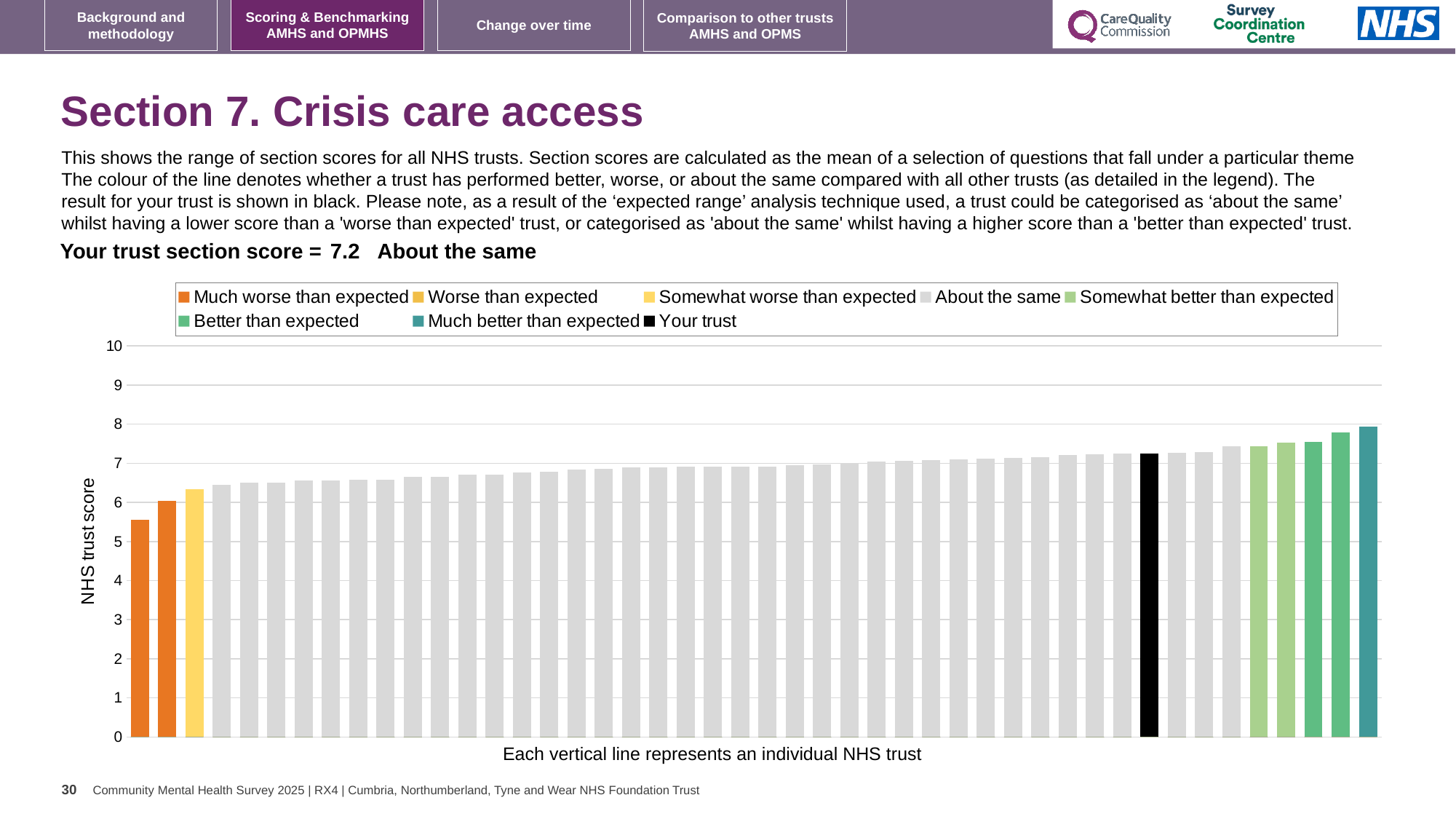
Is the value for your trust (black bar) greater or less than 7? greater Which legend category does the lowest bar on the chart belong to? Much worse than expected Is the value of the lowest bar on the chart greater or less than 6? less Which category is your trust placed in for this section? About the same Which legend category does the highest bar on the chart belong to? Much better than expected What kind of chart is shown on the slide? Bar chart What is the label on the vertical axis of the chart? NHS trust score What is your trust's section score for Crisis care access? 7.2 How many entries does the chart legend list? 8 How many bars are coloured as 'Much worse than expected'? 2 Do the bar values rise or fall from left to right along the x axis? rise